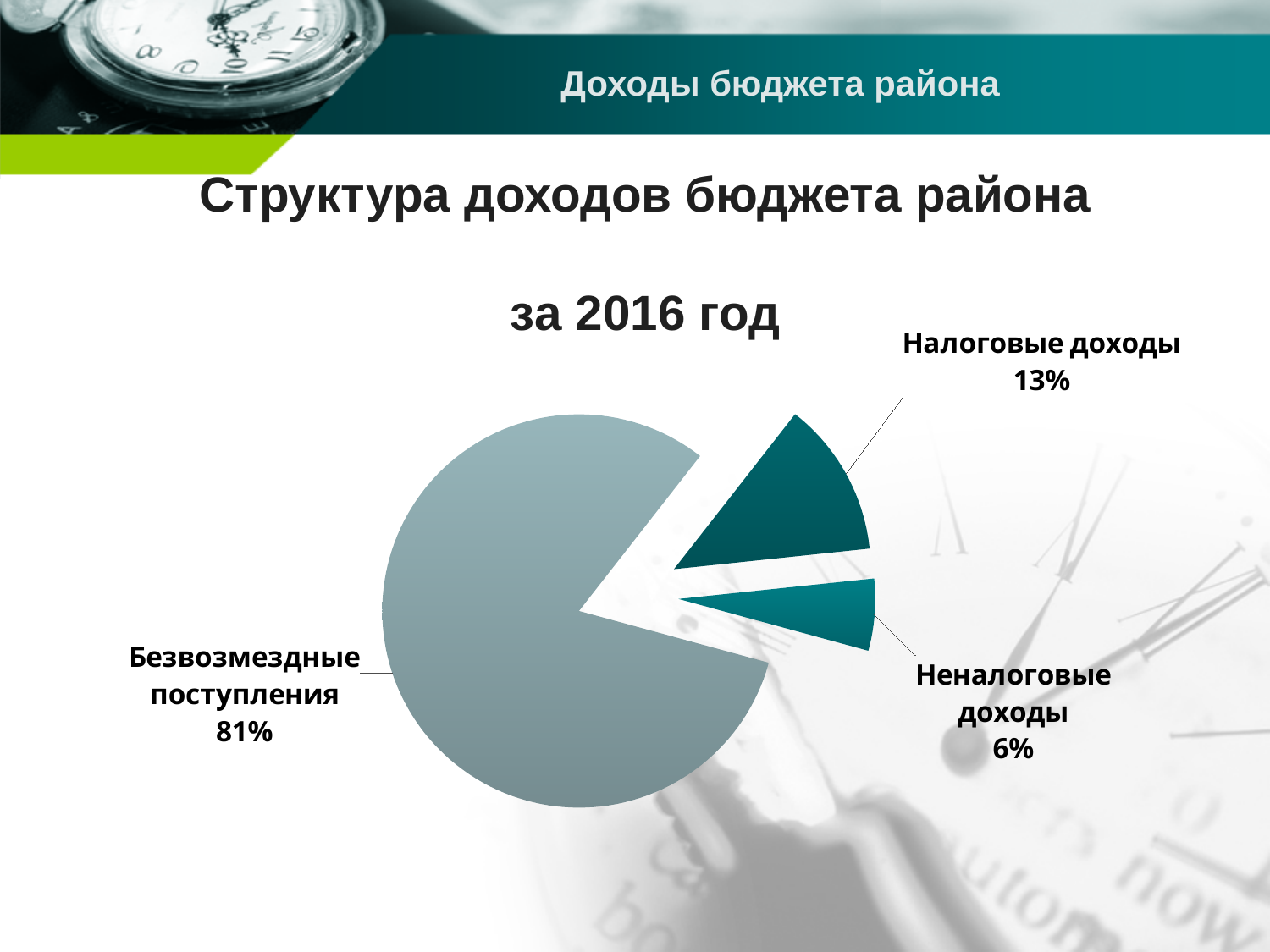
What share of the pie does Неналоговые доходы have? 6% What share of the pie does Налоговые доходы have? 13% What is the difference in percentage points between Налоговые доходы and Неналоговые доходы? 7% Which is larger, Налоговые доходы or Неналоговые доходы? Налоговые доходы Which slice of the pie is the smallest? Неналоговые доходы Which year does the chart title say the data is for? 2016 What is the combined share of Налоговые доходы and Неналоговые доходы? 19% How many slices does the pie chart have? 3 What share of the pie does Безвозмездные поступления have? 81% What is the difference in percentage points between Безвозмездные поступления and Налоговые доходы? 68% Which slice of the pie is the largest? Безвозмездные поступления What kind of chart is shown on the slide? pie chart